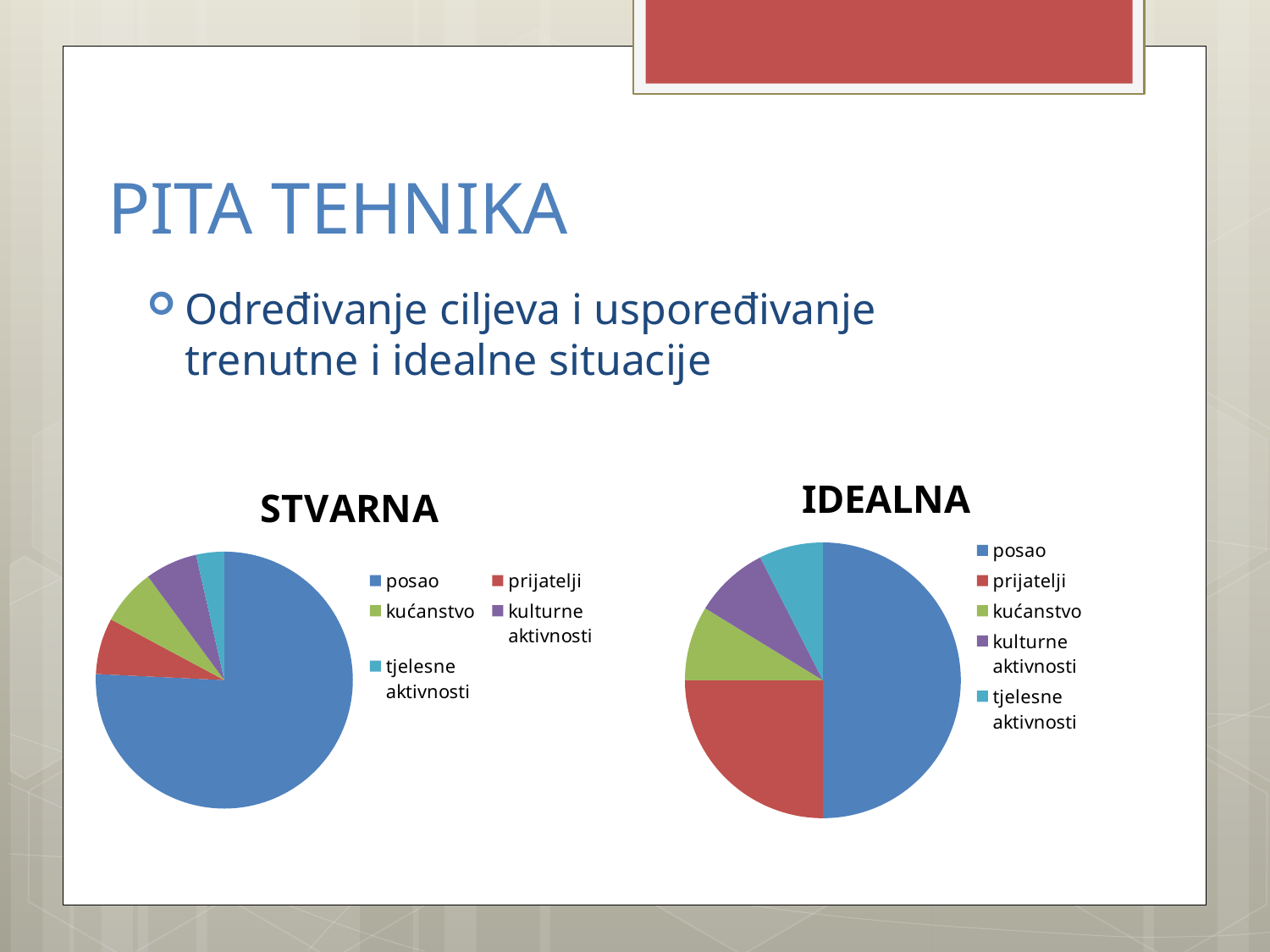
What kind of chart is the STVARNA chart? pie chart In the STVARNA chart, which category has the largest slice? posao In the IDEALNA chart, which category has the largest slice? posao What is the title of the pie chart on the right side of the slide? IDEALNA In the IDEALNA chart, which slice is larger: prijatelji or tjelesne aktivnosti? prijatelji In the IDEALNA chart, which slice is larger: posao or prijatelji? posao In the STVARNA chart, which category has the smallest slice? tjelesne aktivnosti How many categories does the legend of the STVARNA chart list? 5 What kind of chart is the IDEALNA chart? pie chart In the STVARNA chart, which slice is larger: posao or kućanstvo? posao How many categories does the legend of the IDEALNA chart list? 5 In the STVARNA chart, which colour represents posao? blue